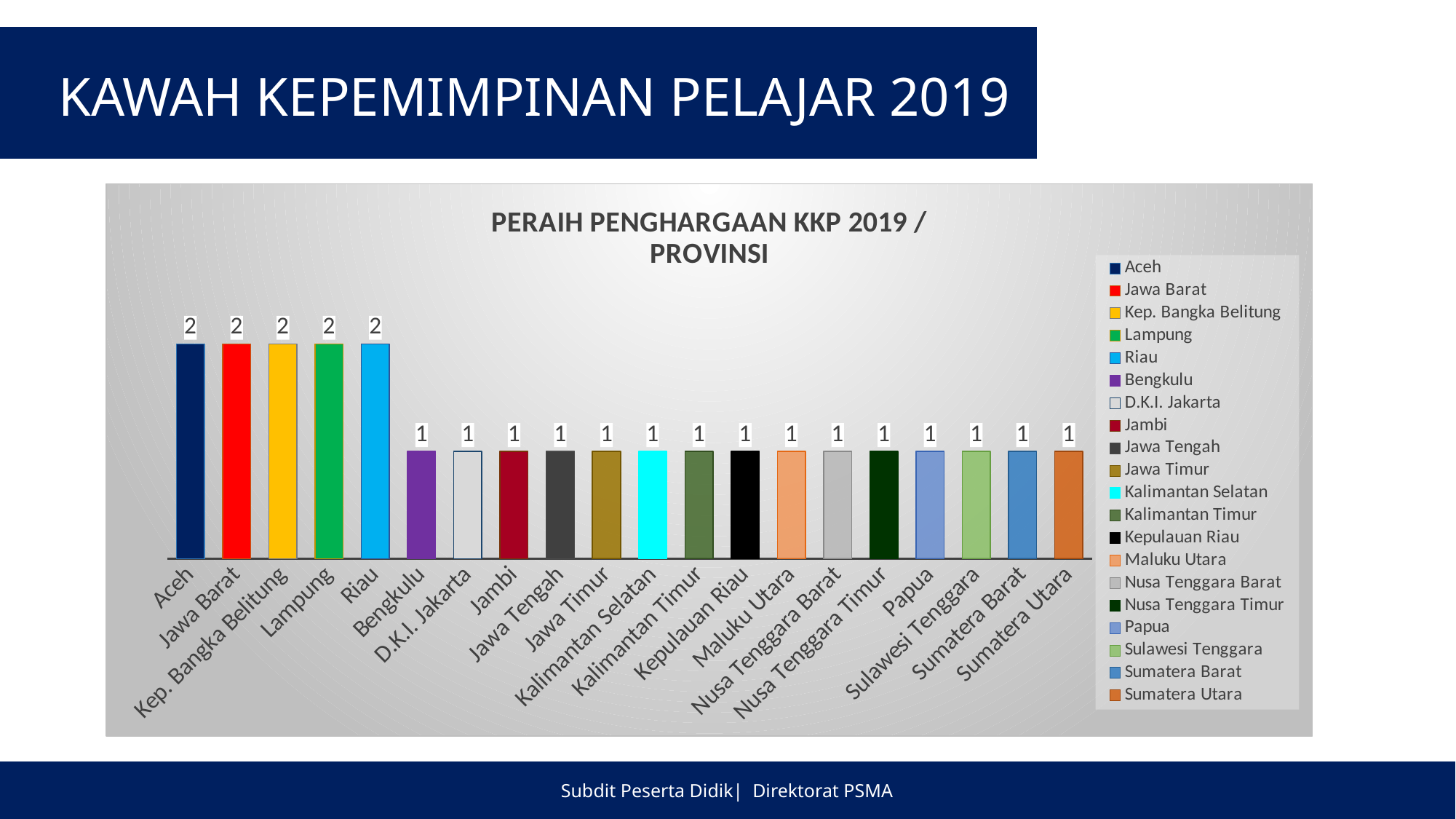
How many provinces are shown on the x axis of the chart? 20 What is the value for Bengkulu? 1 What kind of chart is shown on the slide? Bar chart What is the value for Aceh? 2 Which is larger, the value for Jawa Barat or the value for Jambi? Jawa Barat What is the value for Sumatera Utara? 1 What is the title of the chart? PERAIH PENGHARGAAN KKP 2019 / PROVINSI How many provinces have a value of 2? 5 How many entries does the chart legend list? 20 What is the value for Riau? 2 What is the value for Lampung? 2 What is the difference between the value for Kep. Bangka Belitung and the value for Papua? 1